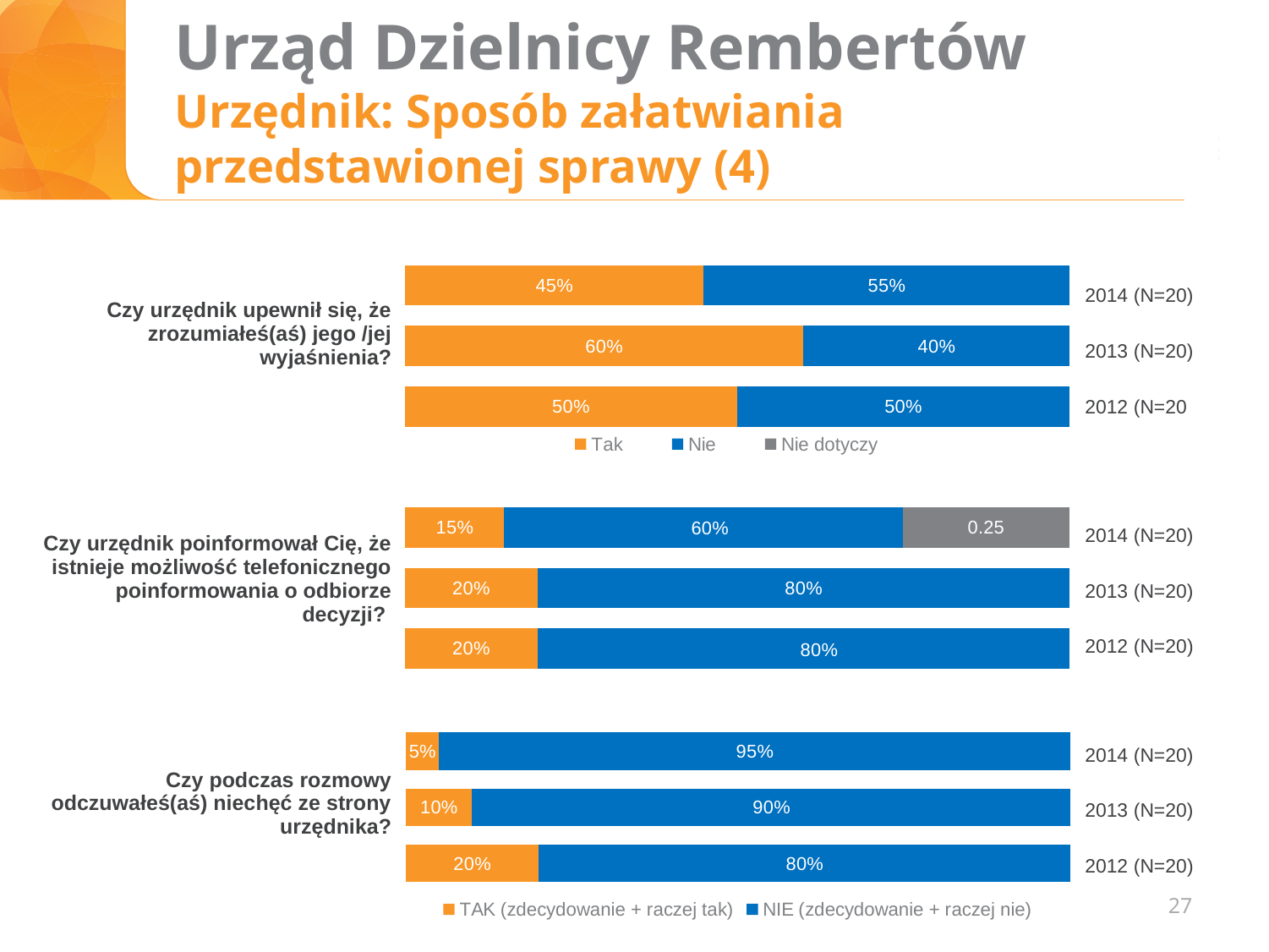
In the top chart (Czy urzędnik upewnił się, że zrozumiałeś(aś) jego/jej wyjaśnienia?), what is the 'Tak' value for 2014 (N=20)? 45% In the top chart (Czy urzędnik upewnił się...), what is the 'Nie' value for 2013 (N=20)? 40% In the middle chart (Czy urzędnik poinformował Cię...), what is the 'Nie dotyczy' value shown for 2014 (N=20)? 0.25 In the bottom chart (Czy podczas rozmowy odczuwałeś(aś) niechęć ze strony urzędnika?), what is the 'TAK' value for 2014 (N=20)? 5% In the bottom chart (Czy podczas rozmowy odczuwałeś(aś) niechęć...), is the 'NIE' value for 2013 larger or smaller than the 'NIE' value for 2012? larger What type of chart is used on this slide? Stacked bar chart In the middle chart (Czy urzędnik poinformował Cię...), what is the 'Tak' value for 2014 (N=20)? 15% In the bottom chart (Czy podczas rozmowy odczuwałeś(aś) niechęć...), which year has the lowest 'TAK' value? 2014 (N=20) In the top chart (Czy urzędnik upewnił się...), which year has the highest 'Tak' value? 2013 (N=20) In the top chart (Czy urzędnik upewnił się...), how many entries does the legend list? 3 How many bars (years) does the bottom chart (Czy podczas rozmowy odczuwałeś(aś) niechęć...) show? 3 In the middle chart (Czy urzędnik poinformował Cię...), what is the difference between the 'Nie' values for 2013 and 2014? 20 percentage points